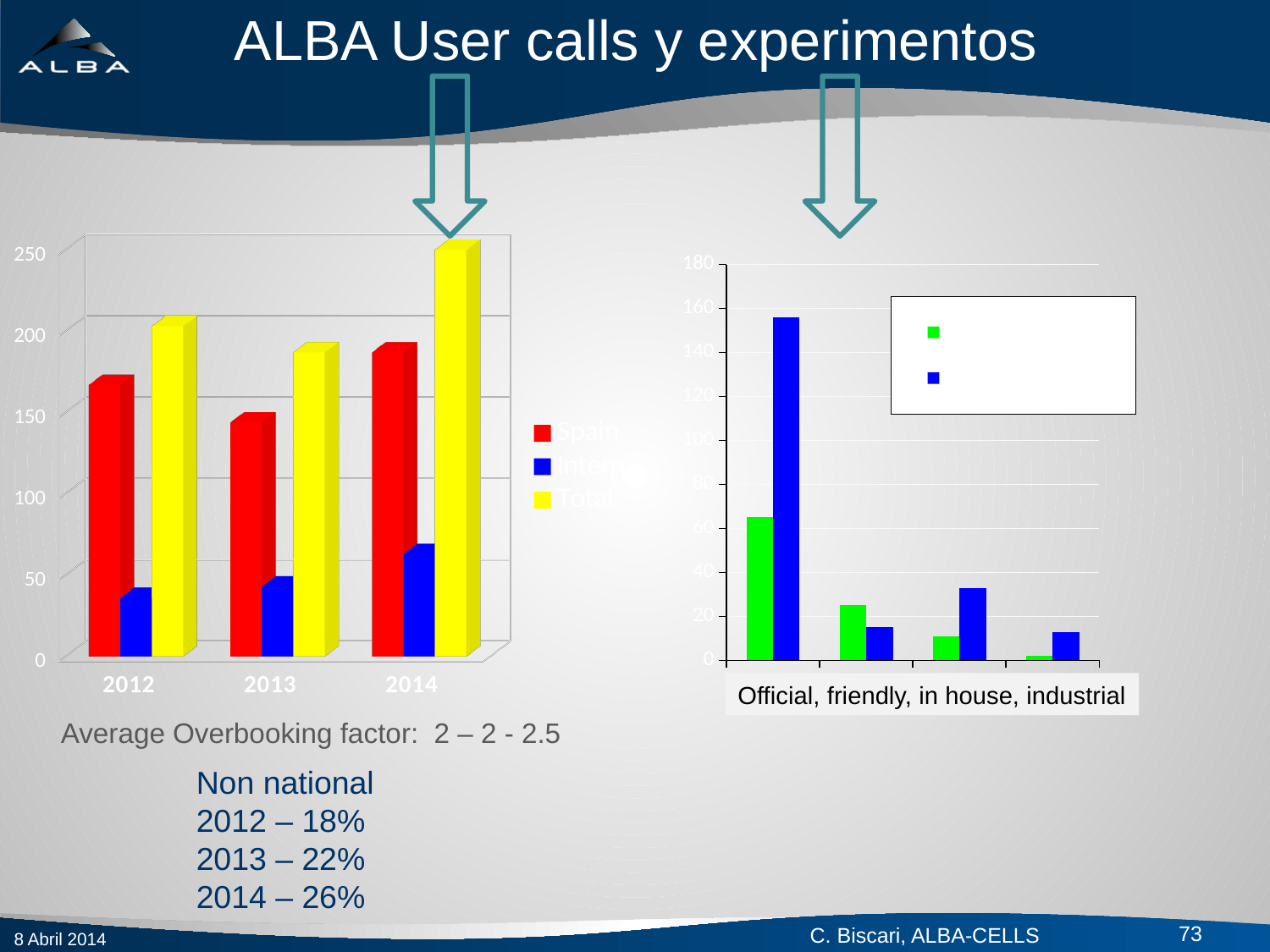
In the chart on the right, which category has the highest green bar? Official In the chart on the right, how many categories are shown on the x axis? 4 In the chart on the left, is the Spain value for 2013 greater or less than 100? greater In the chart on the left, which series is shown in yellow? Total In the chart on the left, is the Total value for 2014 greater or less than 200? greater What kind of chart is the chart on the left of the slide? bar chart In the chart on the left, is the Intern value for 2012 greater or less than 50? less In the chart on the left, how many series does the legend list? 3 In the chart on the left, which is larger for 2014: the Spain value or the Intern value? Spain In the chart on the left, which year has the highest Total value? 2014 In the chart on the left, how many years are shown on the x axis? 3